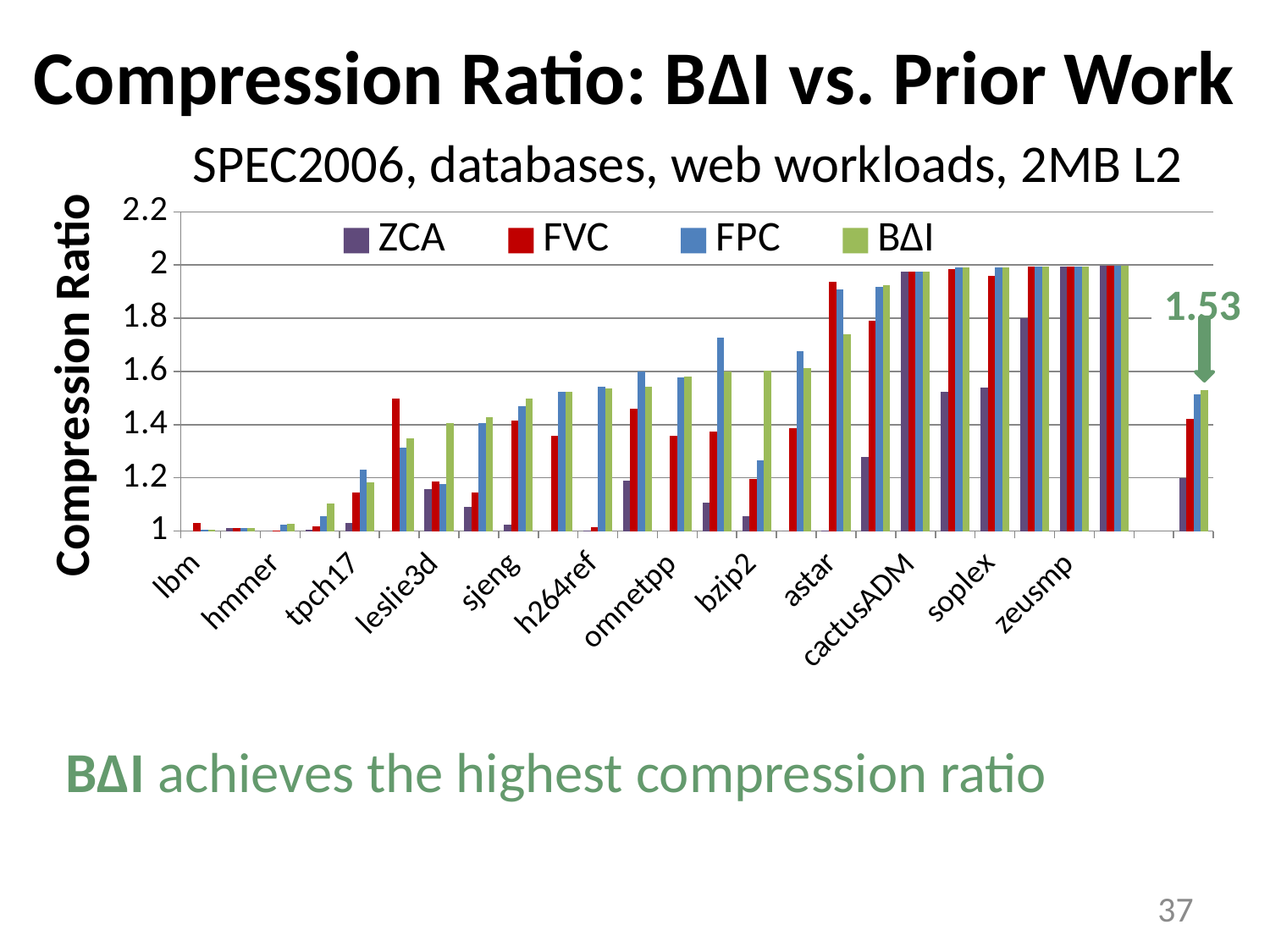
What is the title of the y axis? Compression Ratio What value is printed as a data label above the rightmost group of bars? 1.53 Is the BΔI value for zeusmp greater or less than 1.8? greater Which series are listed in the legend? ZCA, FVC, FPC, BΔI In the rightmost group of bars, which series has the highest value? BΔI Do the compression ratios generally rise or fall moving from left to right across the workloads? rise In the rightmost group of bars, which series has the lowest value? ZCA In the rightmost group of bars, which is larger, the BΔI value or the ZCA value? BΔI How many workload names are printed on the x axis? 12 Is the FVC value for lbm greater or less than 1.2? less How many series does the legend list? 4 What kind of chart is shown on the slide? bar chart